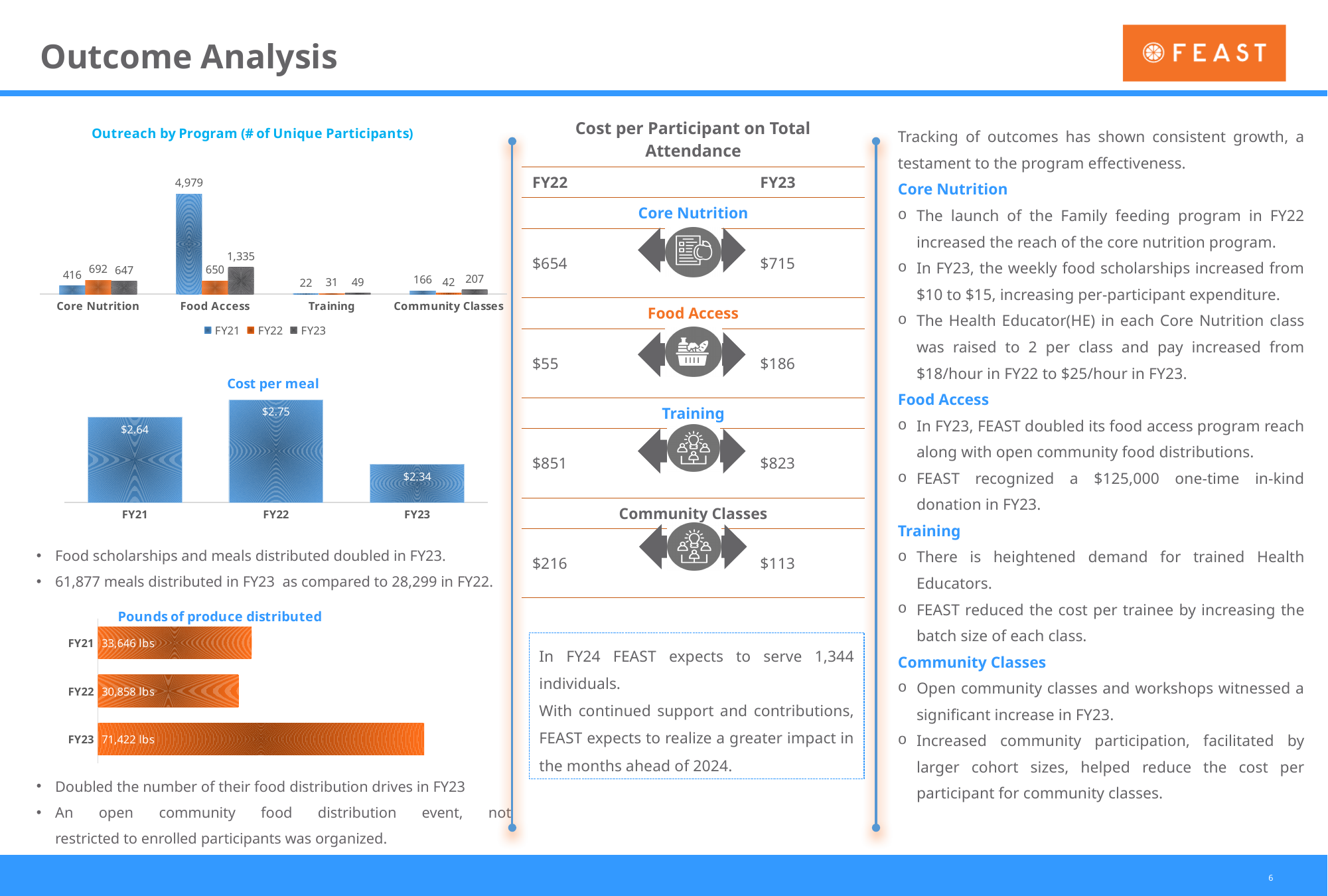
In the 'Pounds of produce distributed' chart, what is the value for FY23? 71,422 lbs In the 'Pounds of produce distributed' chart, which is larger, the FY21 value or the FY22 value? FY21 In the 'Outreach by Program (# of Unique Participants)' chart, which program has the lowest FY22 value? Training In the 'Outreach by Program (# of Unique Participants)' chart, how many series does the legend list? 3 In the 'Outreach by Program (# of Unique Participants)' chart, how many program categories are shown on the x axis? 4 In the 'Cost per meal' chart, which fiscal year has the lowest cost per meal? FY23 In the 'Outreach by Program (# of Unique Participants)' chart, what is the difference between the FY23 and FY22 values for Food Access? 685 What kind of chart is 'Pounds of produce distributed'? Bar chart In the 'Outreach by Program (# of Unique Participants)' chart, what is the FY21 value for Food Access? 4,979 In the 'Cost per meal' chart, what is the difference between the FY22 and FY23 values? $0.41 In the 'Outreach by Program (# of Unique Participants)' chart, what is the FY23 value for Community Classes? 207 In the 'Cost per meal' chart, what is the value for FY22? $2.75